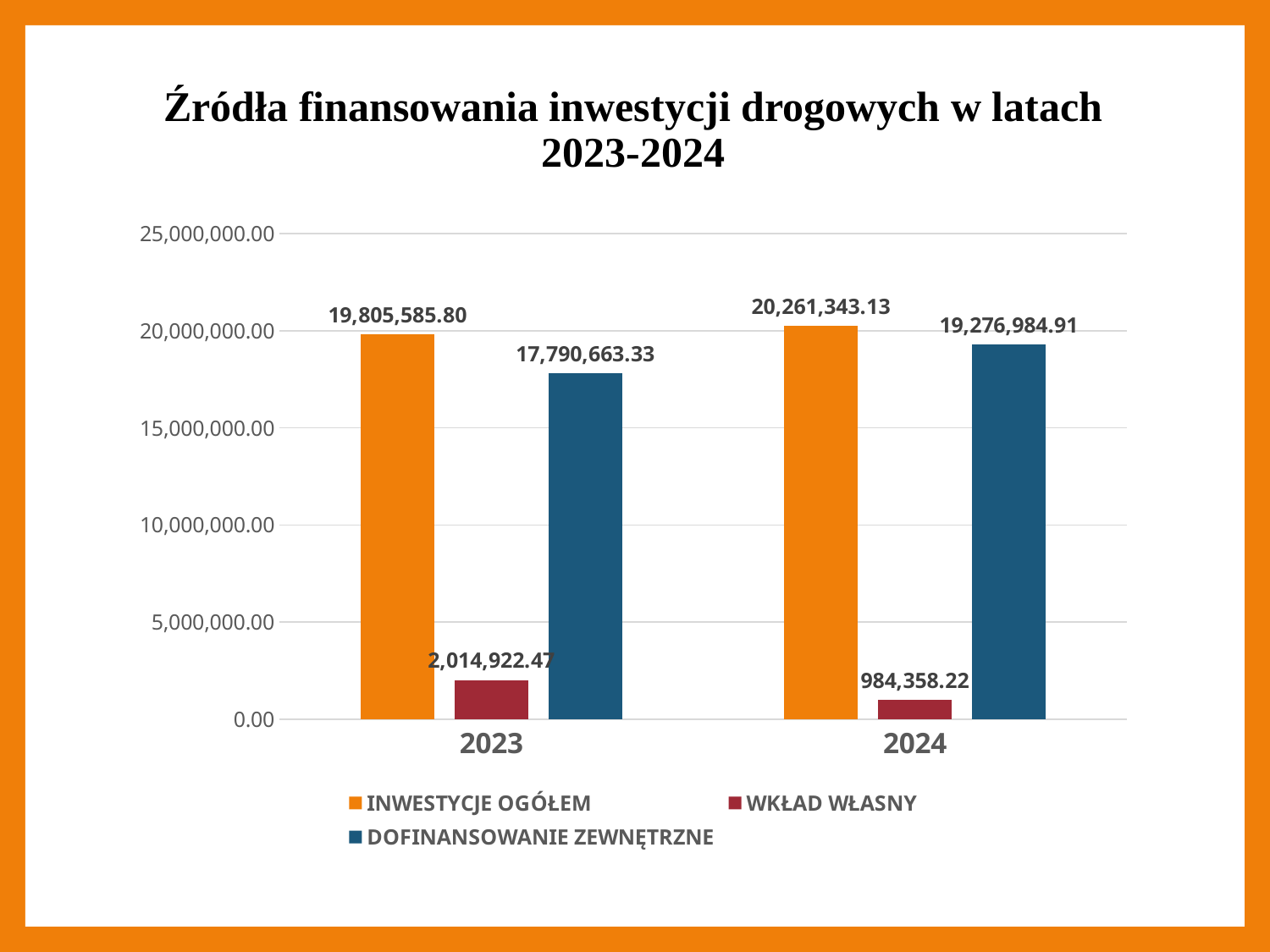
What is the difference between INWESTYCJE OGÓŁEM in 2024 and in 2023? 455,757.33 What is the difference between DOFINANSOWANIE ZEWNĘTRZNE in 2024 and in 2023? 1,486,321.58 What is the value of WKŁAD WŁASNY for 2024? 984,358.22 What kind of chart is shown on the slide? Bar chart What is the value of INWESTYCJE OGÓŁEM for 2023? 19,805,585.80 What is the value of DOFINANSOWANIE ZEWNĘTRZNE for 2023? 17,790,663.33 What is the value of INWESTYCJE OGÓŁEM for 2024? 20,261,343.13 Does DOFINANSOWANIE ZEWNĘTRZNE rise or fall from 2023 to 2024? Rise Which series has the lowest value in 2023? WKŁAD WŁASNY Which series has the highest value in 2024? INWESTYCJE OGÓŁEM Is WKŁAD WŁASNY larger in 2023 or in 2024? 2023 How many series does the legend list? 3